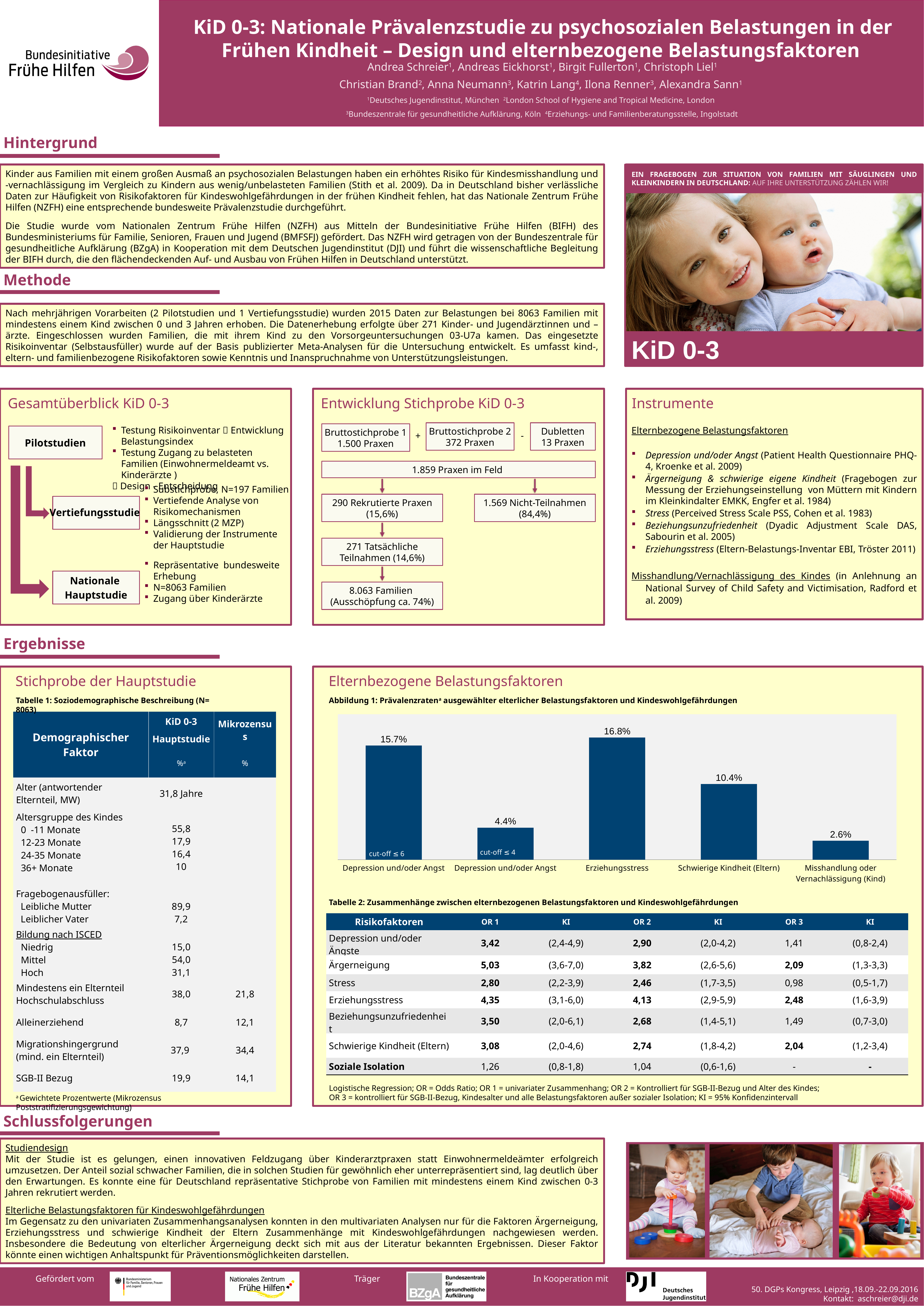
Which category has the highest value in the chart? Erziehungsstress What is the value shown for Schwierige Kindheit (Eltern) in the chart? 10.4% What type of chart is Abbildung 1? Bar chart What is the value shown for Misshandlung oder Vernachlässigung (Kind) in the chart? 2.6% What is the difference between the two Depression und/oder Angst bars (cut-off ≤ 6 and cut-off ≤ 4)? 11.3% Which is larger: the value for Schwierige Kindheit (Eltern) or the value for Depression und/oder Angst with cut-off ≤ 4? Schwierige Kindheit (Eltern) How many bars are shown in the chart? 5 Which category has the lowest value in the chart? Misshandlung oder Vernachlässigung (Kind) What is the value shown for Depression und/oder Angst with cut-off ≤ 6 in the chart? 15.7% What is the value shown for Erziehungsstress in the chart? 16.8% What is the value shown for Depression und/oder Angst with cut-off ≤ 4 in the chart? 4.4% What is the difference between the values for Erziehungsstress and Schwierige Kindheit (Eltern)? 6.4%